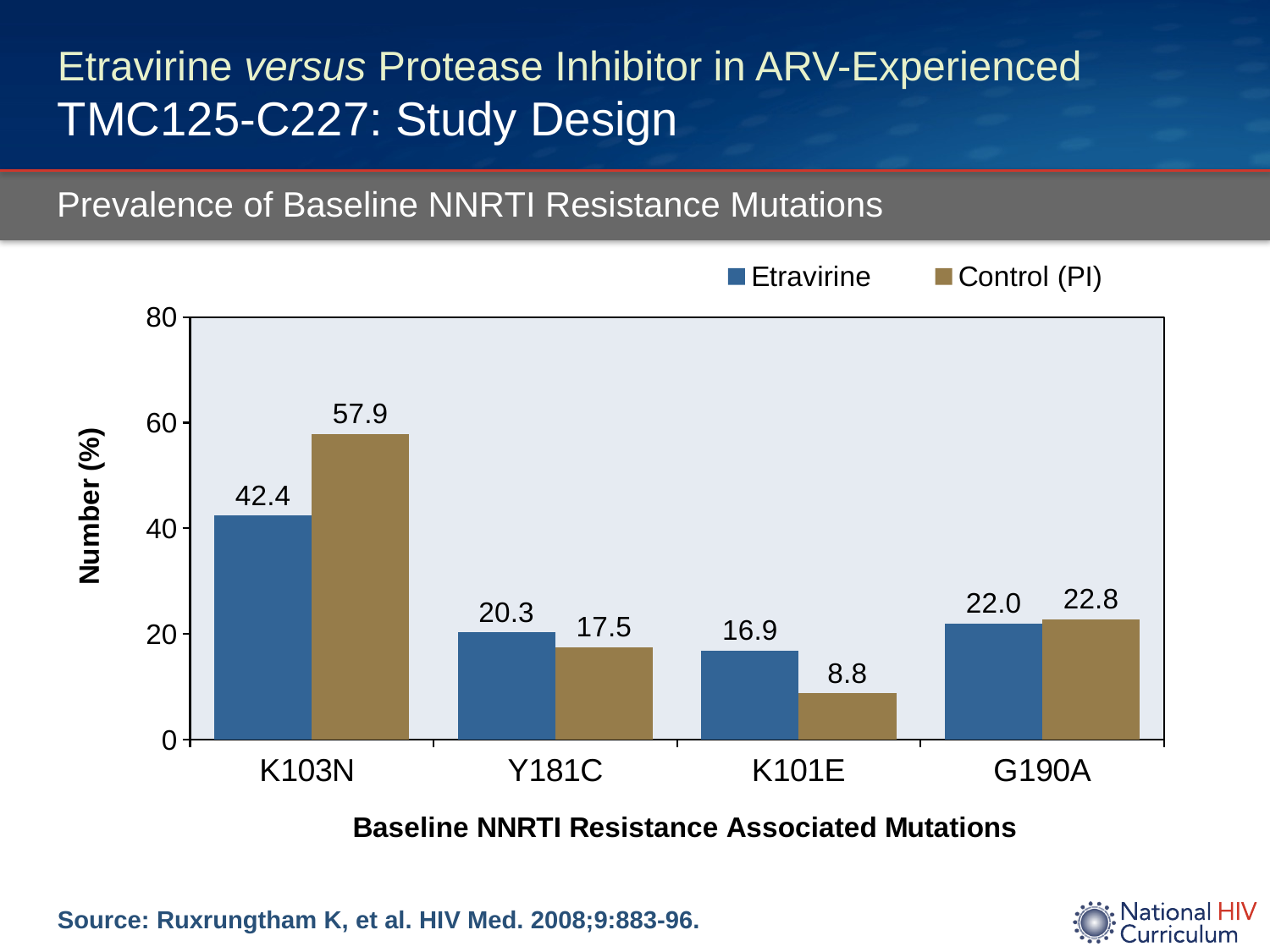
What is the Control (PI) value for G190A? 22.8 Which mutation has the lowest Etravirine value? K101E For Y181C, which is larger: the Etravirine value or the Control (PI) value? Etravirine What is the difference between the Control (PI) and Etravirine values for K103N? 15.5 How many mutation categories are shown on the x axis? 4 What is the Control (PI) value for K101E? 8.8 Which mutation has the highest Control (PI) value? K103N What is the Etravirine value for K103N? 42.4 What is the label of the y axis? Number (%) How many series does the legend list? 2 Is the Etravirine value for K103N greater or less than 40? greater What kind of chart is shown on the slide? Bar chart